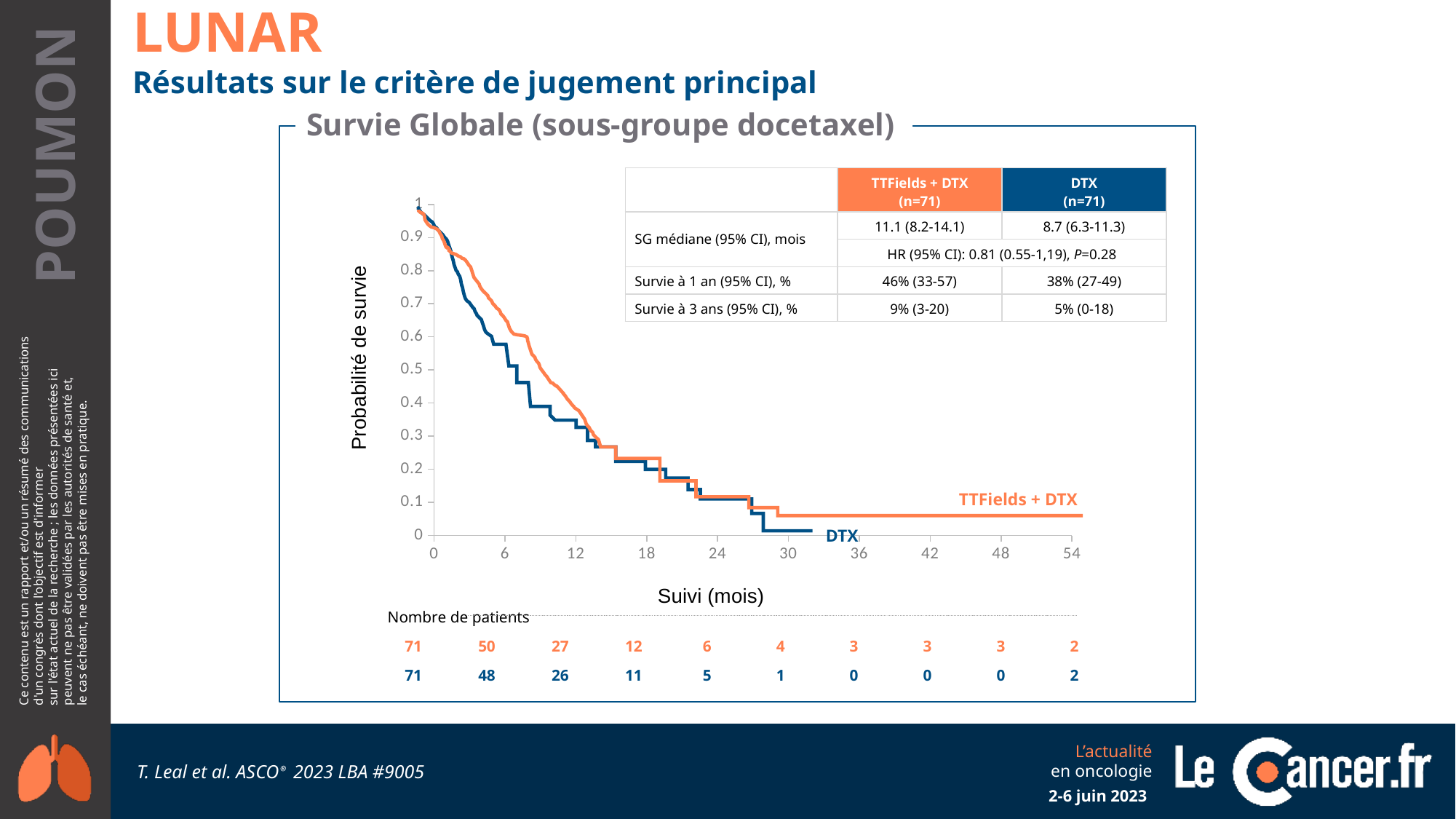
How many treatment arms (series) are plotted on the survival chart? 2 Which arm has the higher median overall survival, TTFields + DTX or DTX? TTFields + DTX What is the 1-year survival rate for the DTX arm? 38% (27-49) What is the 3-year survival rate for the TTFields + DTX arm? 9% (3-20) What kind of chart is shown on the slide? line chart (Kaplan-Meier survival curve) What is the difference in 1-year survival between the TTFields + DTX arm (46%) and the DTX arm (38%)? 8 percentage points Is the survival probability of the TTFields + DTX curve at 6 months greater or less than 0.5? greater What is the median overall survival (SG médiane) for the DTX arm? 8.7 (6.3-11.3) What is the hazard ratio (HR) with its 95% CI shown in the table? 0.81 (0.55-1,19) How many patients were at risk in the DTX arm at 18 months? 11 What is the median overall survival (SG médiane) for the TTFields + DTX arm? 11.1 (8.2-14.1) What is the label of the x axis of the survival chart? Suivi (mois)